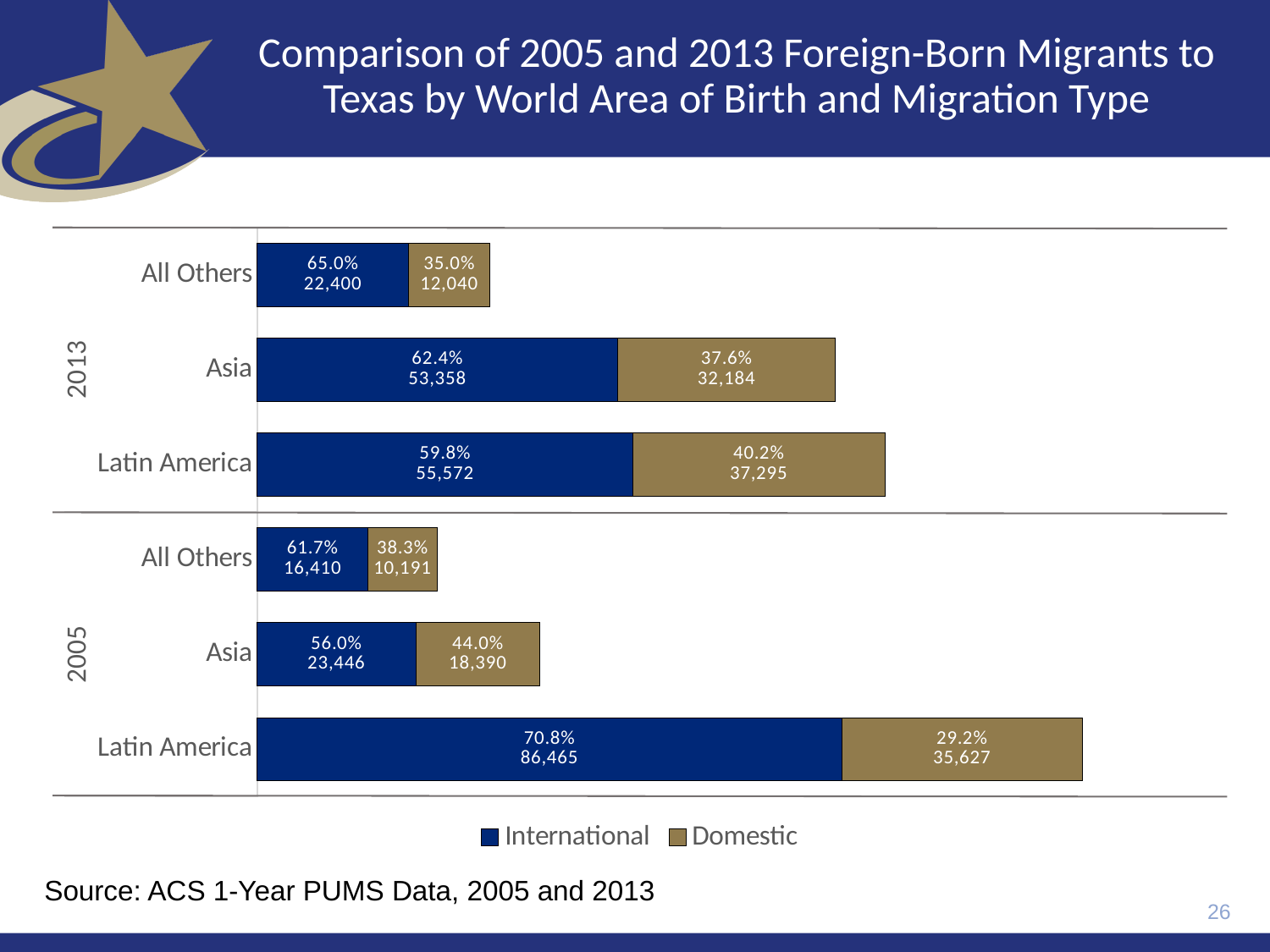
Which category and year has the smallest Domestic value? All Others, 2005 How many bars are shown in the chart? 6 What is the total of the Asia bar for 2013? 85,542 What is the difference between the International and Domestic values for Asia in 2013? 21,174 What percentage of 2005 Latin America migrants were Domestic? 29.2% What is the International value for Asia in 2013? 53,358 Is the Domestic value for Asia larger in 2005 or in 2013? 2013 Which category and year has the largest International value? Latin America, 2005 What is the total of the Latin America bar for 2005? 122,092 What kind of chart is shown on the slide? Stacked bar chart What is the Domestic value for All Others in 2013? 12,040 How many series does the legend list? 2